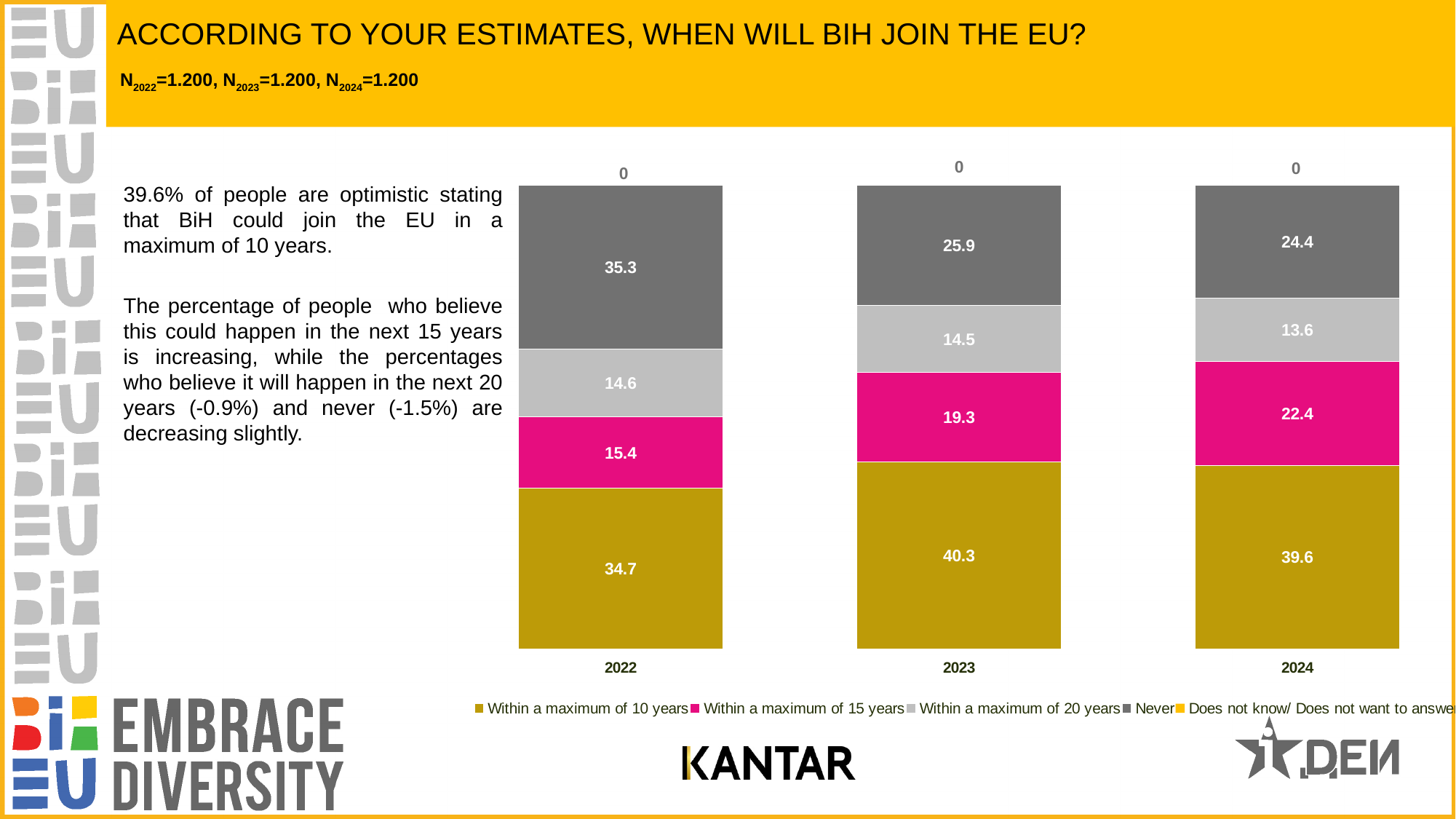
What kind of chart is shown on the slide? Stacked bar chart Does the value for 'Within a maximum of 15 years' rise or fall from 2022 to 2024? Rise What is the value for 'Never' in 2022? 35.3 What is the value for 'Within a maximum of 15 years' in 2024? 22.4 In which year is the value for 'Within a maximum of 15 years' highest? 2024 How many series does the legend list? 5 How many years are shown on the x axis? 3 Which is larger in 2022: 'Within a maximum of 10 years' or 'Never'? Never What is the value for 'Within a maximum of 20 years' in 2023? 14.5 What is the value for 'Within a maximum of 10 years' in 2023? 40.3 In which year is the value for 'Never' lowest? 2024 What is the difference between the 'Never' values in 2022 and 2024? 10.9